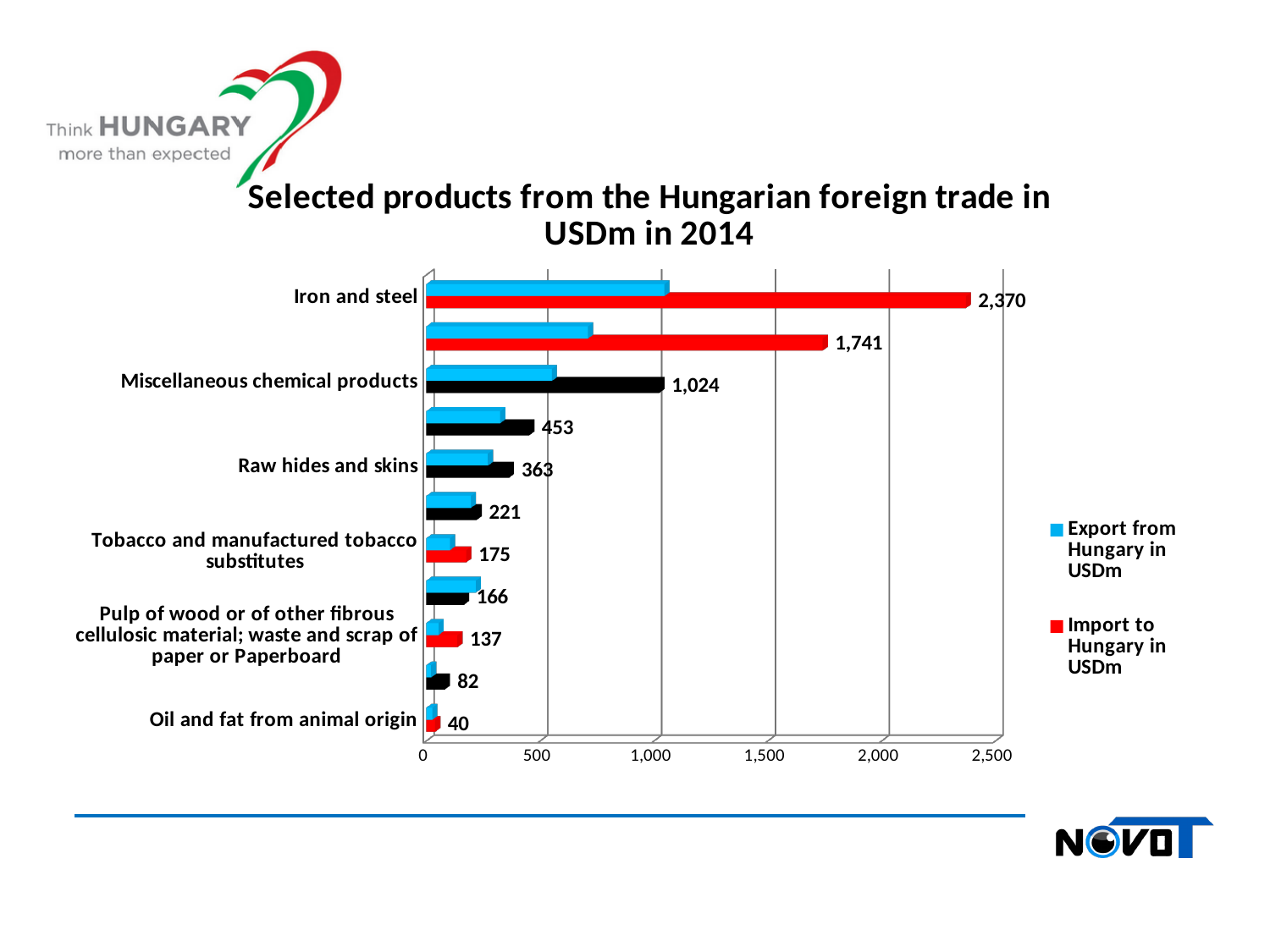
For Iron and steel, which is larger: the export from Hungary or the import to Hungary? Import to Hungary How many series does the legend list? 2 Which product has the lowest import to Hungary value? Oil and fat from animal origin What is the import to Hungary value for Raw hides and skins? 363 What is the difference between the import values for Iron and steel and Miscellaneous chemical products? 1,346 What is the import to Hungary value for Tobacco and manufactured tobacco substitutes? 175 What kind of chart is shown on the slide? Bar chart What is the import to Hungary value for Miscellaneous chemical products? 1,024 Is the export from Hungary value for Raw hides and skins greater or less than 500? less What is the import to Hungary value for Oil and fat from animal origin? 40 Which product has the highest import to Hungary value? Iron and steel What is the import to Hungary value for Iron and steel? 2,370